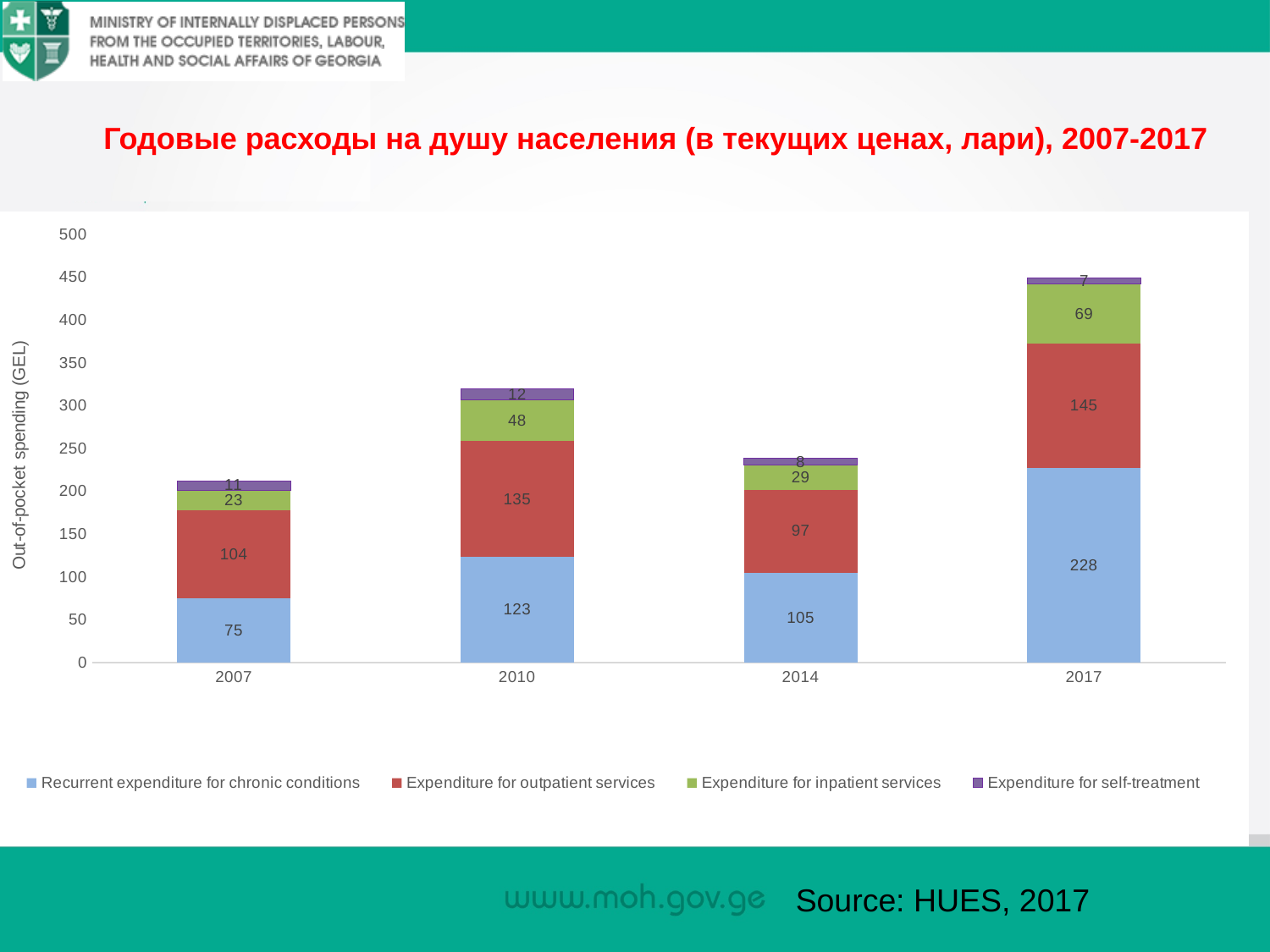
What kind of chart is shown on the slide? Stacked bar chart Which is larger in 2014: Recurrent expenditure for chronic conditions or Expenditure for outpatient services? Recurrent expenditure for chronic conditions What is the value of Expenditure for inpatient services in 2014? 29 How many years are shown on the x axis? 4 What is the total of the stacked bar for 2010? 318 What is the value of Recurrent expenditure for chronic conditions in 2017? 228 What is the value of Expenditure for self-treatment in 2007? 11 What is the value of Expenditure for outpatient services in 2010? 135 In which year is Expenditure for outpatient services highest? 2017 How many series does the legend list? 4 In which year is Expenditure for self-treatment lowest? 2017 What is the difference between Recurrent expenditure for chronic conditions in 2017 and in 2007? 153